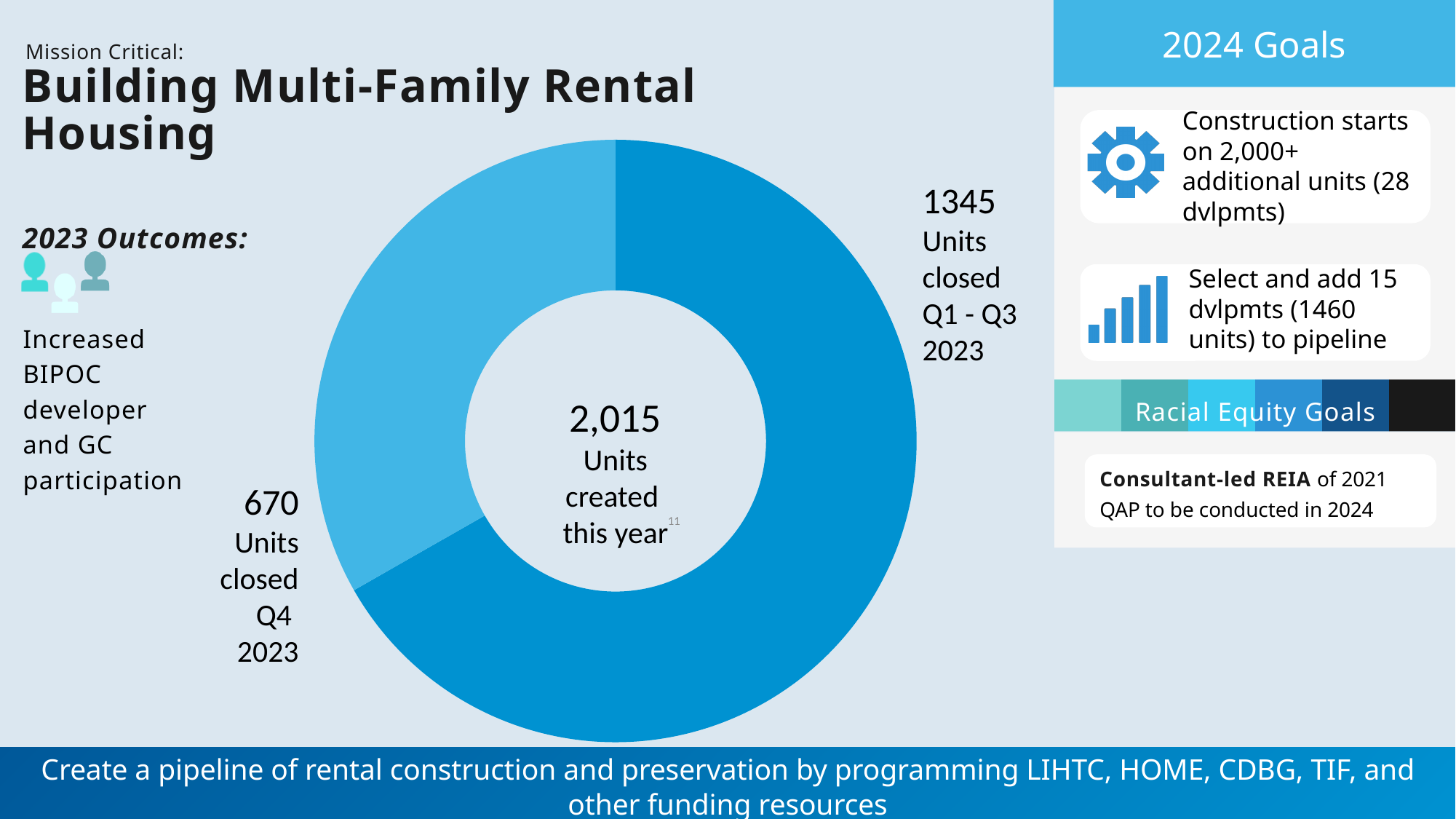
How many units were closed in Q4 2023 according to the donut chart? 670 What text appears in the centre of the donut chart? 2,015 Units created this year Were more units closed in Q4 2023 or in Q1 - Q3 2023? Q1 - Q3 2023 What is the total number of units created this year, as shown in the centre of the donut chart? 2,015 Is the number of units closed in Q4 2023 greater or less than 1000? less What is the difference between the units closed in Q1 - Q3 2023 and the units closed in Q4 2023? 675 Which period has the smaller slice in the donut chart? Q4 2023 How many units were closed in Q1 - Q3 2023 according to the donut chart? 1345 What kind of chart is shown on the slide? Donut (pie) chart How many slices does the donut chart have? 2 Which slice of the donut chart is shown in the lighter blue colour? 670 Units closed Q4 2023 Which period has the larger slice in the donut chart, Q1 - Q3 2023 or Q4 2023? Q1 - Q3 2023